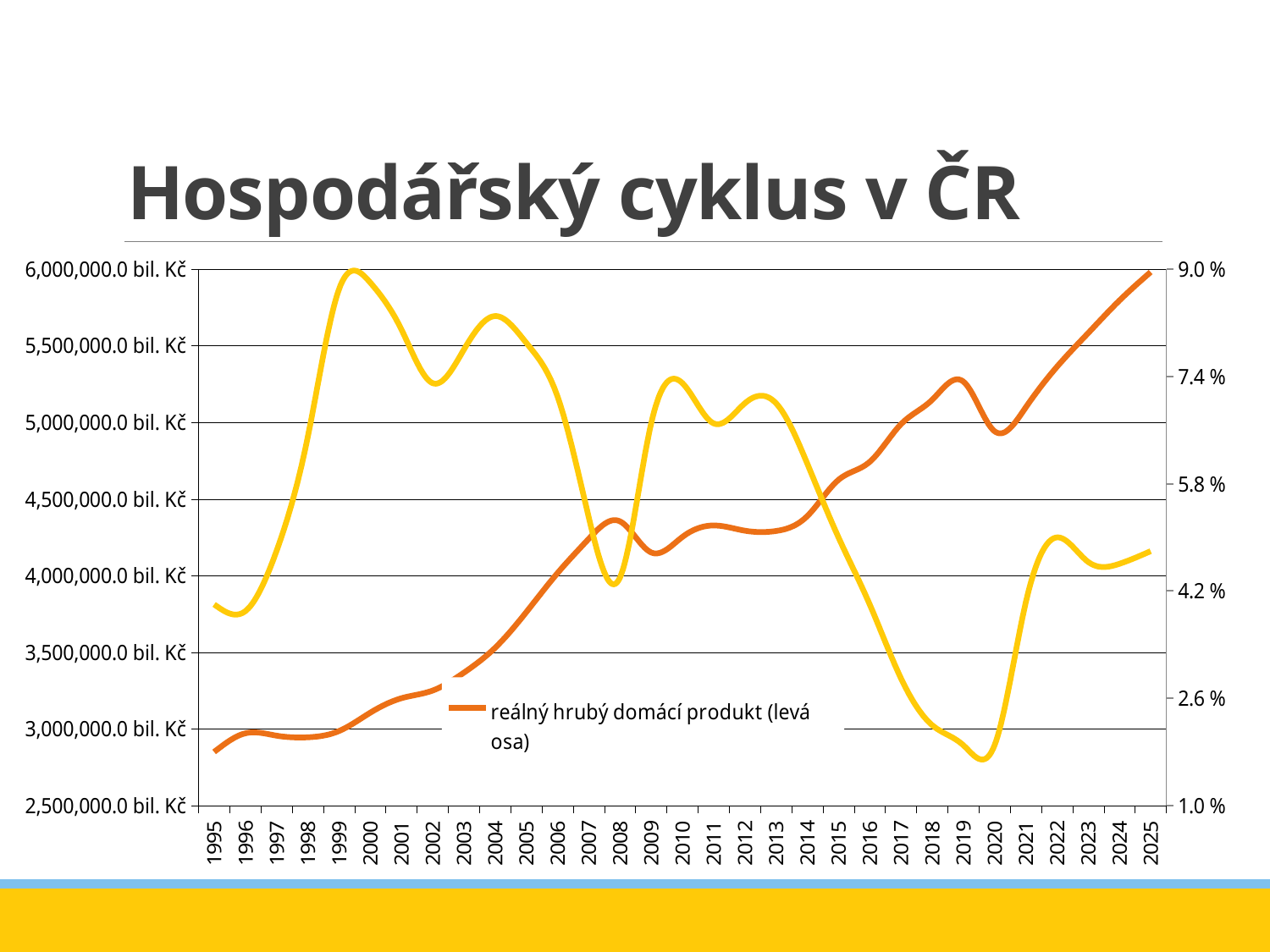
How many years are labelled on the x axis? 31 Is the value of the yellow line (right axis) in 2019 greater or less than 2.6 %? less In which year is the orange line (reálný hrubý domácí produkt) at its highest? 2025 Is the value of the orange line (reálný hrubý domácí produkt) in 1995 greater or less than 3,000,000.0 bil. Kč? less Which year has the higher value on the yellow line (right axis), 2004 or 2008? 2004 Is the value of the orange line (reálný hrubý domácí produkt) in 2025 greater or less than 5,500,000.0 bil. Kč? greater In which year is the orange line (reálný hrubý domácí produkt) at its lowest? 1995 What kind of chart is shown on the slide? line chart How many lines are plotted on the chart? 2 What is the title of the chart? Hospodářský cyklus v ČR Does the orange line (reálný hrubý domácí produkt) rise or fall overall from 1995 to 2025? rise What series name does the legend show for the orange line? reálný hrubý domácí produkt (levá osa)